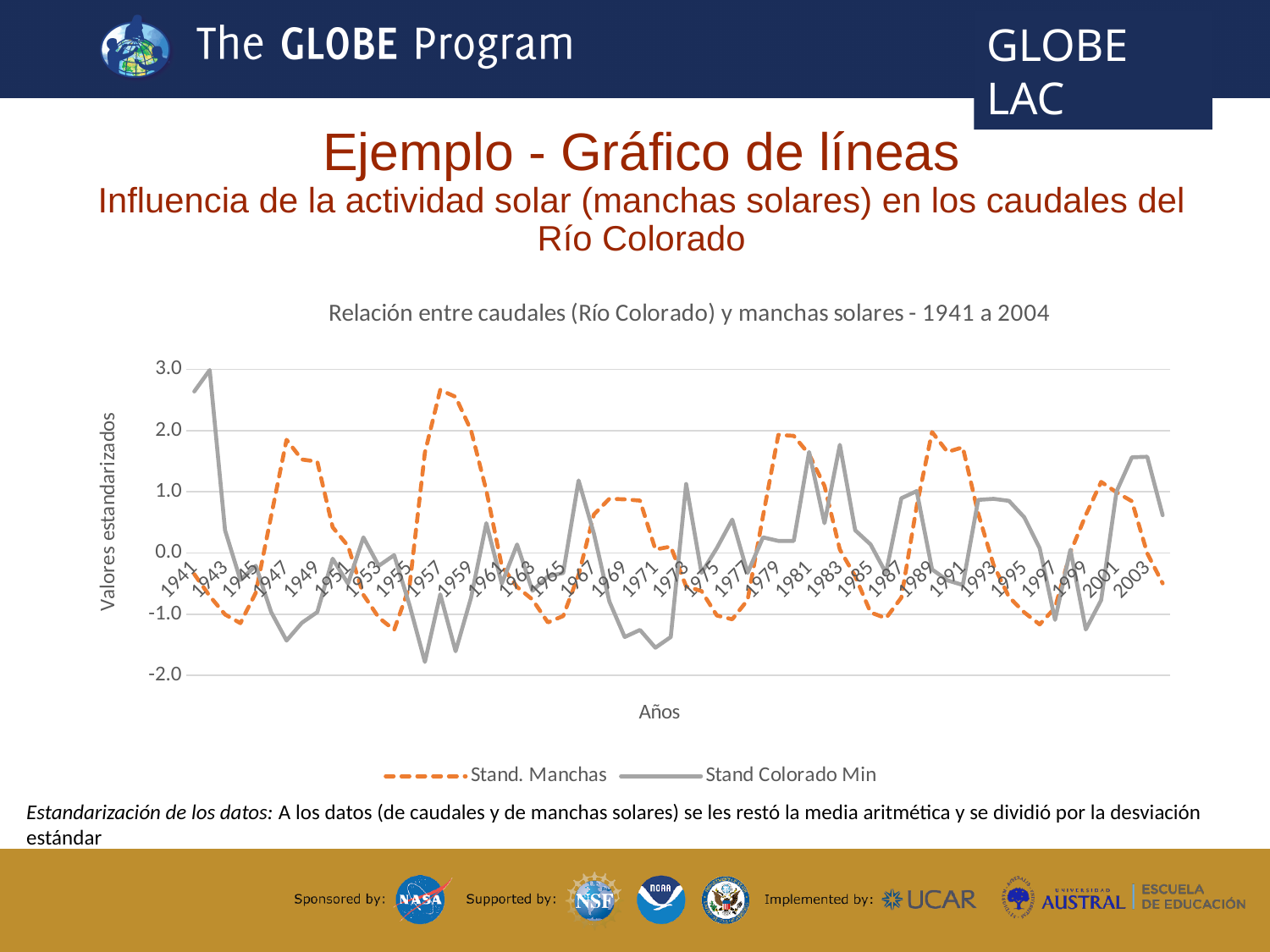
In 1943, which series has the higher value, Stand. Manchas or Stand Colorado Min? Stand Colorado Min What is the label of the vertical axis of the chart? Valores estandarizados How many series does the chart legend list? 2 Is the value of Stand Colorado Min in 1956 greater or less than -1.0? less What kind of chart is shown on the slide? line chart Which series reaches the highest value anywhere on the chart? Stand Colorado Min What is the title of the chart? Relación entre caudales (Río Colorado) y manchas solares - 1941 a 2004 Is the value of Stand. Manchas in 1957 greater or less than 2.0? greater Is the value of Stand Colorado Min in 1973 greater or less than -1.0? greater